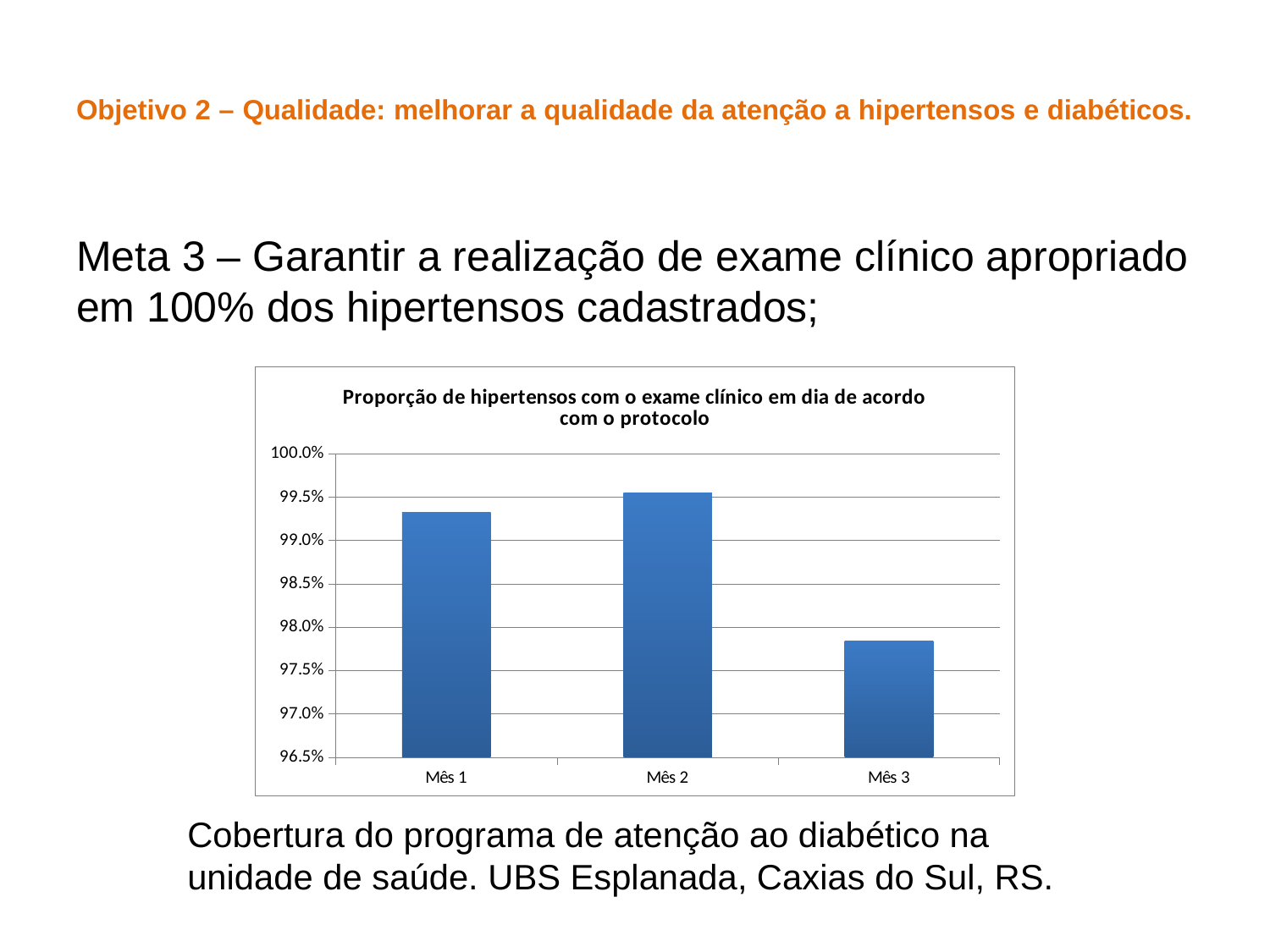
Is the value for Mês 3 greater or less than 98.0%? less Do the values rise or fall from Mês 2 to Mês 3? fall Is the value for Mês 3 greater or less than 97.5%? greater What kind of chart is shown on the slide? Bar chart What is the title of the chart? Proporção de hipertensos com o exame clínico em dia de acordo com o protocolo Is the value for Mês 1 greater or less than 99.0%? greater How many months (categories) are plotted in the chart? 3 Which month has the highest proportion of hypertensive patients with an up-to-date clinical exam? Mês 2 Which is larger, the value for Mês 1 or the value for Mês 3? Mês 1 Which month has the lowest proportion of hypertensive patients with an up-to-date clinical exam? Mês 3 Which is larger, the value for Mês 1 or the value for Mês 2? Mês 2